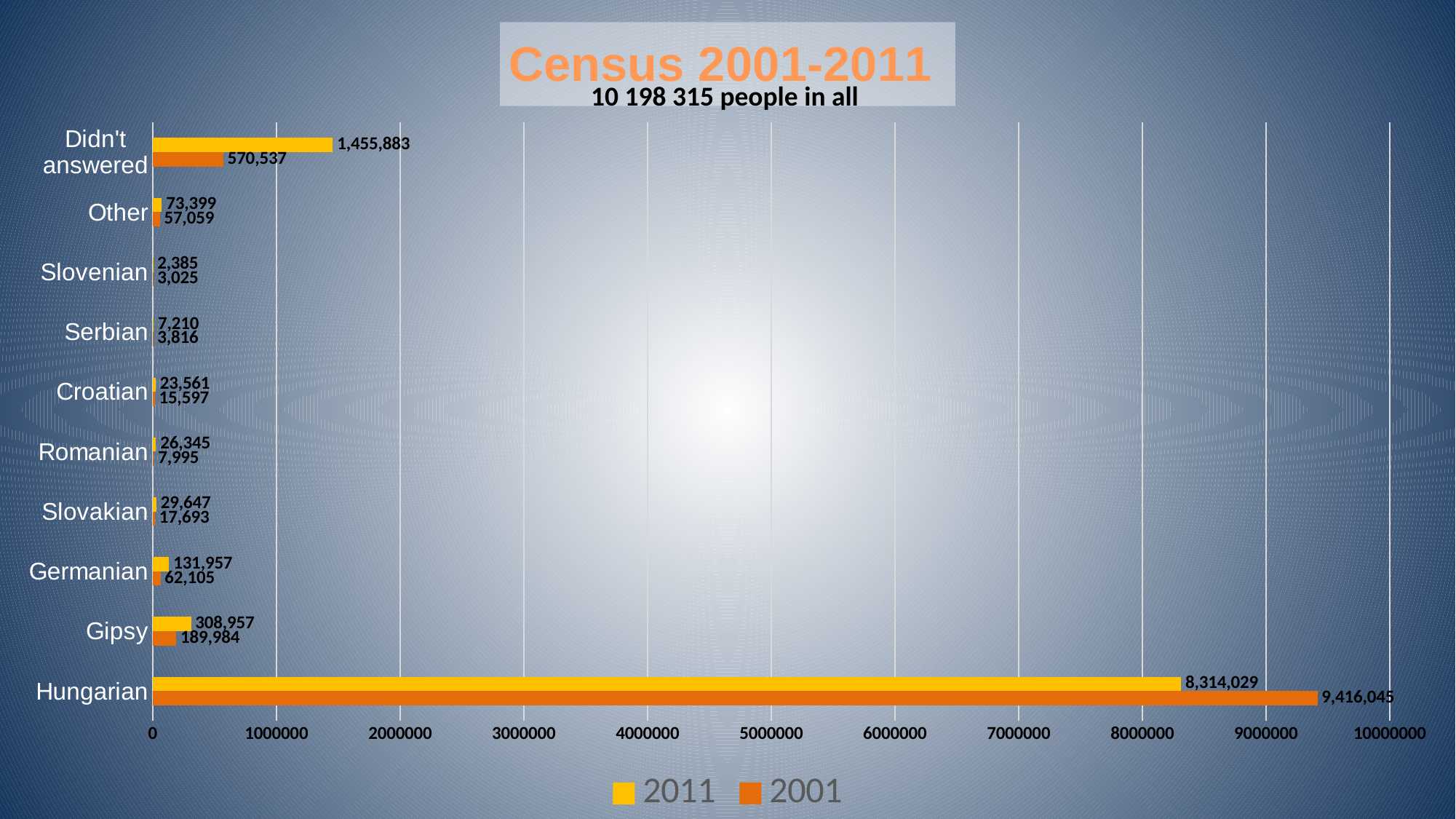
What is the 2001 value for Gipsy? 189,984 Which category has the highest 2011 value? Hungarian How many series does the legend list? 2 What type of chart is shown on the slide? Bar chart Which category has the lowest 2011 value? Slovenian What is the 2011 value for Hungarian? 8,314,029 How many categories are shown on the chart? 10 Which is larger for Slovenian: the 2011 value or the 2001 value? 2001 What is the 2011 value for Germanian? 131,957 What is the title of the chart? Census 2001-2011 What is the difference between the 2001 and 2011 values for Hungarian? 1,102,016 What is the 2001 value for Didn't answered? 570,537